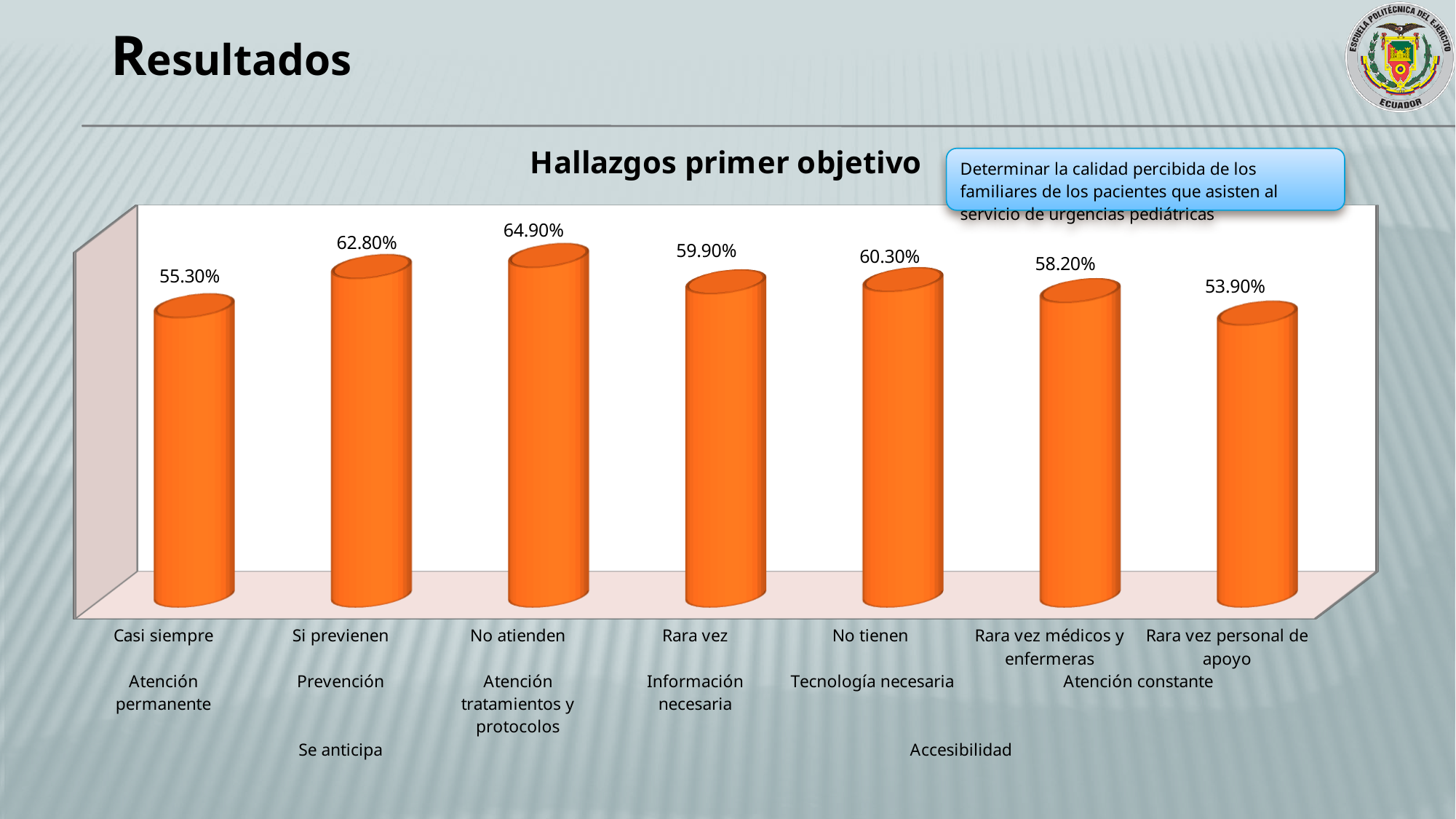
What is the value for 'Rara vez personal de apoyo'? 53.90% What is the title of the chart? Hallazgos primer objetivo What is the value for 'No atienden'? 64.90% What is the difference between the values for 'No atienden' and 'Casi siempre'? 9.60% What is the value for 'Casi siempre'? 55.30% What is the value for 'Si previenen'? 62.80% How many bars are shown in the chart? 7 What kind of chart is shown on the slide? Bar chart Which category has the highest value? No atienden What is the difference between the values for 'No tienen' and 'Rara vez'? 0.40% Which is larger, the value for 'Si previenen' or the value for 'Rara vez médicos y enfermeras'? Si previenen Which category has the lowest value? Rara vez personal de apoyo